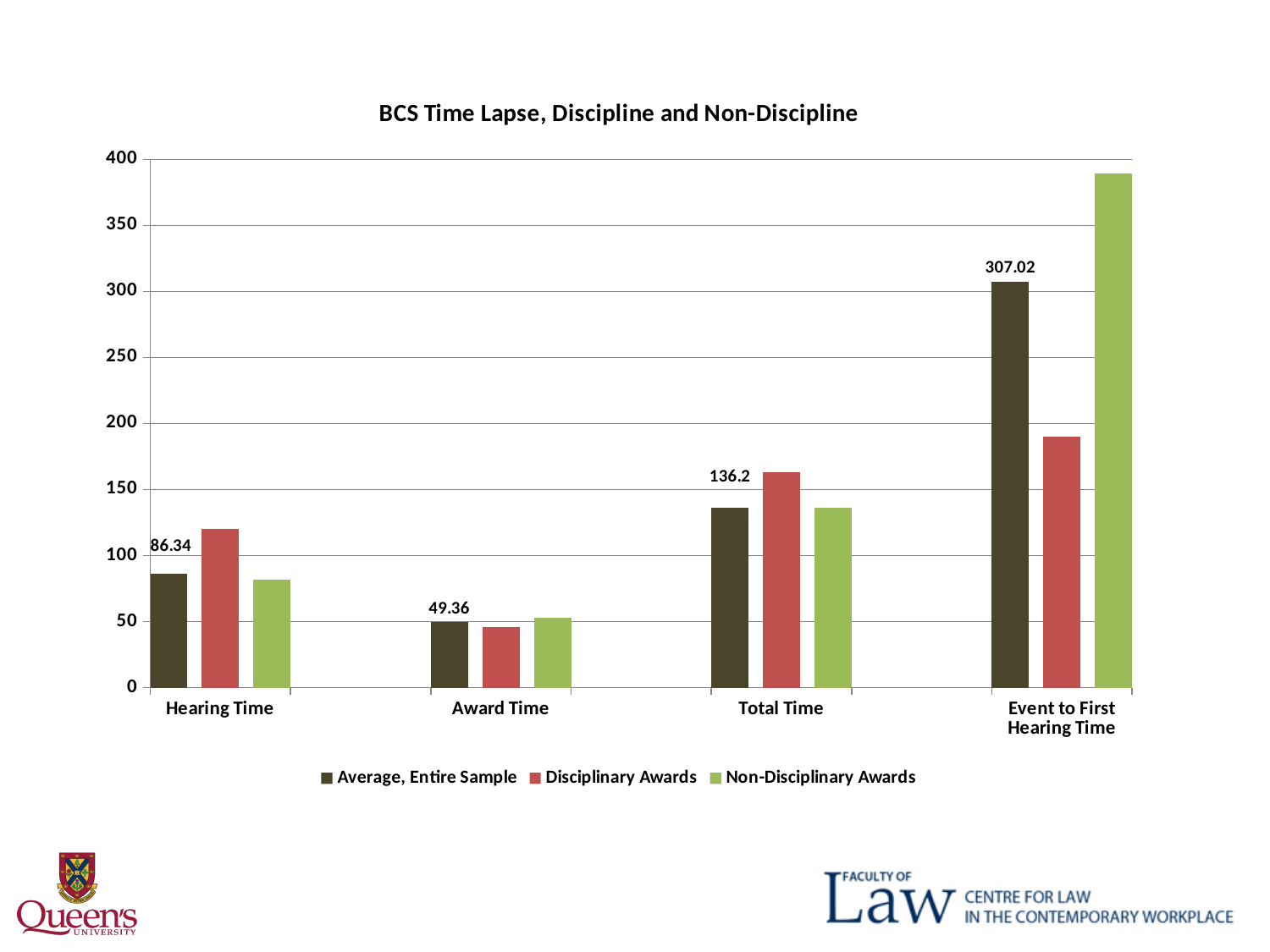
What is the difference between the Average, Entire Sample values for Event to First Hearing Time and Hearing Time? 220.68 What is the value for Average, Entire Sample for Hearing Time? 86.34 For Event to First Hearing Time, which is larger: Disciplinary Awards or Non-Disciplinary Awards? Non-Disciplinary Awards How many categories are shown on the x axis? 4 What is the value for Average, Entire Sample for Total Time? 136.2 How many series does the legend list? 3 Which category has the highest value for Average, Entire Sample? Event to First Hearing Time What is the value for Average, Entire Sample for Event to First Hearing Time? 307.02 What kind of chart is shown on the slide? bar chart Is the value for Non-Disciplinary Awards for Event to First Hearing Time greater or less than 350? greater Which category has the lowest value for Average, Entire Sample? Award Time What is the value for Average, Entire Sample for Award Time? 49.36